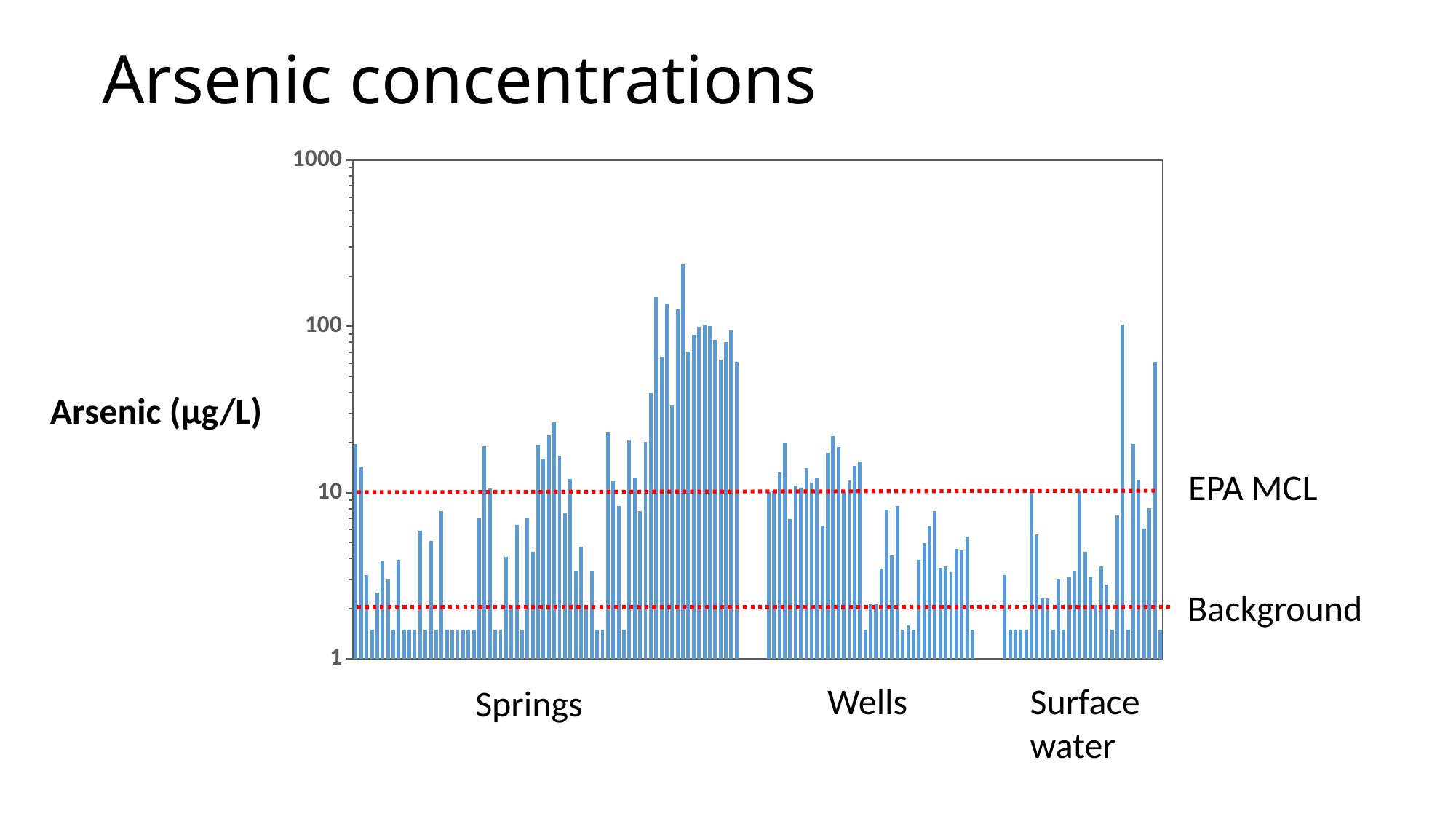
Is the tallest bar in the Surface water group greater or less than 10 µg/L? greater Which sample group contains the tallest bar in the chart? Springs At what value on the vertical axis does the EPA MCL dotted line sit? 10 What is the title of the slide's chart? Arsenic concentrations Which of the two dotted reference lines is higher on the chart, EPA MCL or Background? EPA MCL Is the tallest bar in the Wells group greater or less than 100 µg/L? less Is the Background dotted line greater or less than 10 µg/L? less How many sample groups are labelled along the x axis of the chart? 3 What is the highest value shown on the vertical axis of the chart? 1000 What kind of chart is shown on the slide? bar chart What is the label on the vertical axis of the chart? Arsenic (µg/L)